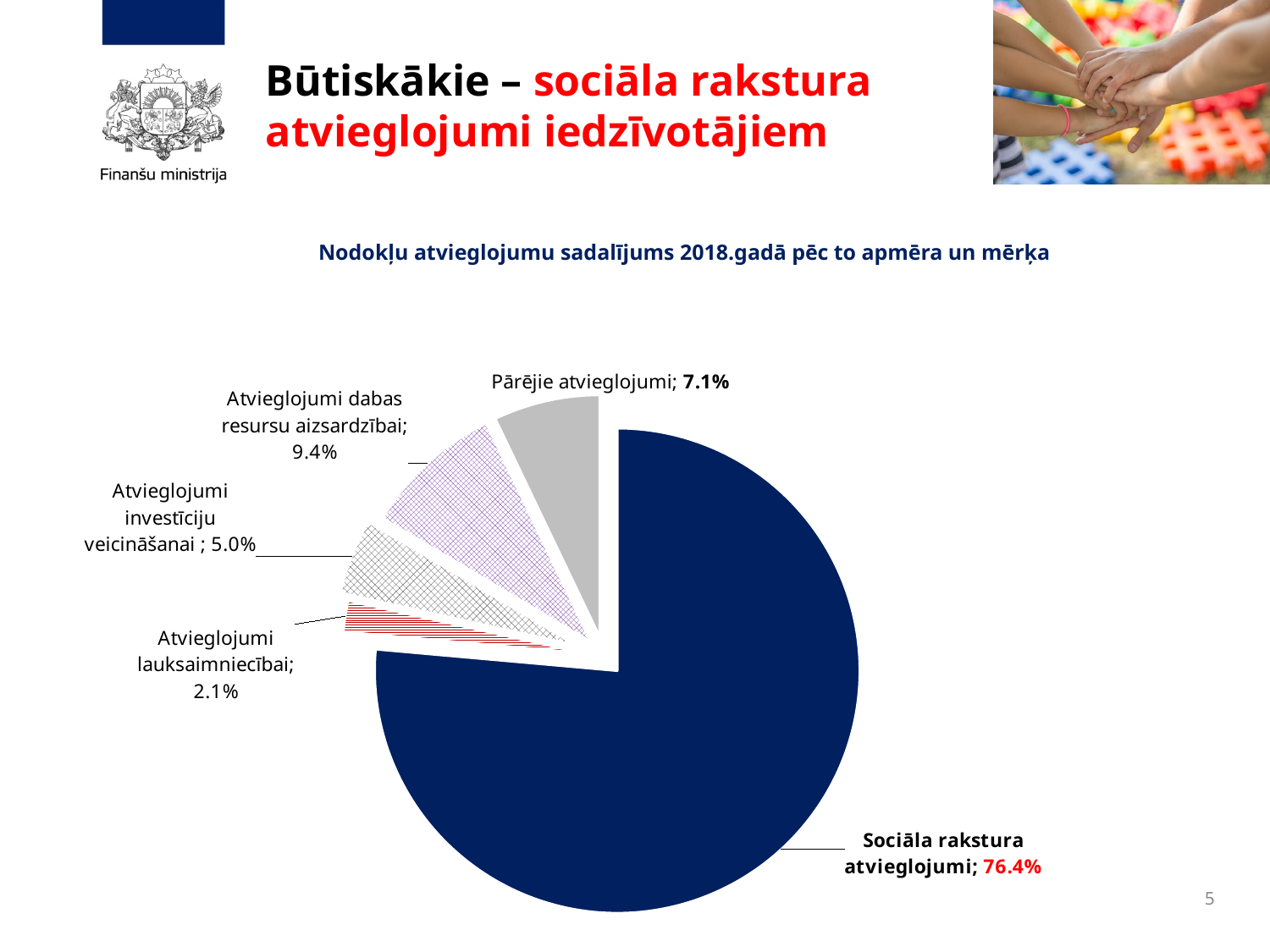
Which category has the largest share of the pie? Sociāla rakstura atvieglojumi Which category has the smallest share of the pie? Atvieglojumi lauksaimniecībai How many slices does the pie chart have? 5 Which is larger, the share of Atvieglojumi investīciju veicināšanai or Atvieglojumi lauksaimniecībai? Atvieglojumi investīciju veicināšanai What is the difference between the shares of Atvieglojumi dabas resursu aizsardzībai and Pārējie atvieglojumi? 2.3% What is the value for Pārējie atvieglojumi? 7.1% What is the value for Atvieglojumi dabas resursu aizsardzībai? 9.4% What share of the pie is Sociāla rakstura atvieglojumi? 76.4% What is the value for Atvieglojumi lauksaimniecībai? 2.1% What kind of chart is shown on the slide? pie chart What is the title of the chart? Nodokļu atvieglojumu sadalījums 2018.gadā pēc to apmēra un mērķa What is the value for Atvieglojumi investīciju veicināšanai? 5.0%